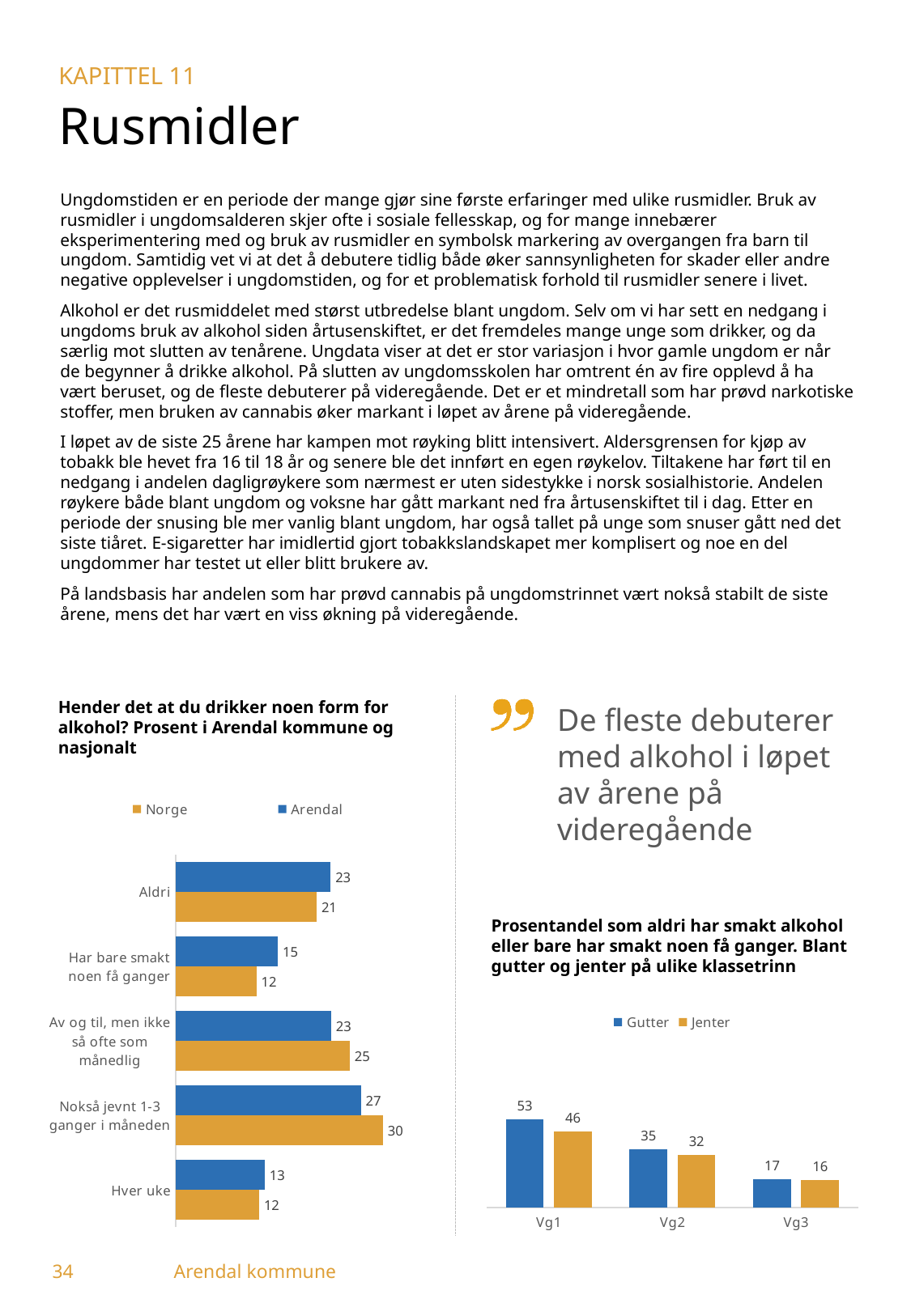
In the chart 'Prosentandel som aldri har smakt alkohol eller bare har smakt noen få ganger', what is the value for Jenter at Vg1? 46 In the chart 'Prosentandel som aldri har smakt alkohol eller bare har smakt noen få ganger', do the values for Gutter rise or fall from Vg1 to Vg3? Fall In the chart 'Hender det at du drikker noen form for alkohol?', what is the value for Arendal in the category 'Aldri'? 23 In the chart 'Hender det at du drikker noen form for alkohol?', what is the difference between Norge and Arendal in the category 'Har bare smakt noen få ganger'? 3 In the chart 'Prosentandel som aldri har smakt alkohol eller bare har smakt noen få ganger', which colour represents Jenter? Orange How many categories are shown in the chart 'Hender det at du drikker noen form for alkohol?'? 5 In the chart 'Hender det at du drikker noen form for alkohol?', which is larger in the category 'Av og til, men ikke så ofte som månedlig': Norge or Arendal? Norge What kind of chart is the chart 'Hender det at du drikker noen form for alkohol?'? Bar chart How many series does the legend list in the chart 'Hender det at du drikker noen form for alkohol?'? 2 In the chart 'Prosentandel som aldri har smakt alkohol eller bare har smakt noen få ganger', what is the difference between Gutter and Jenter at Vg2? 3 In the chart 'Hender det at du drikker noen form for alkohol?', what is the value for Norge in the category 'Nokså jevnt 1-3 ganger i måneden'? 30 In the chart 'Hender det at du drikker noen form for alkohol?', which category has the highest value for Arendal? Nokså jevnt 1-3 ganger i måneden